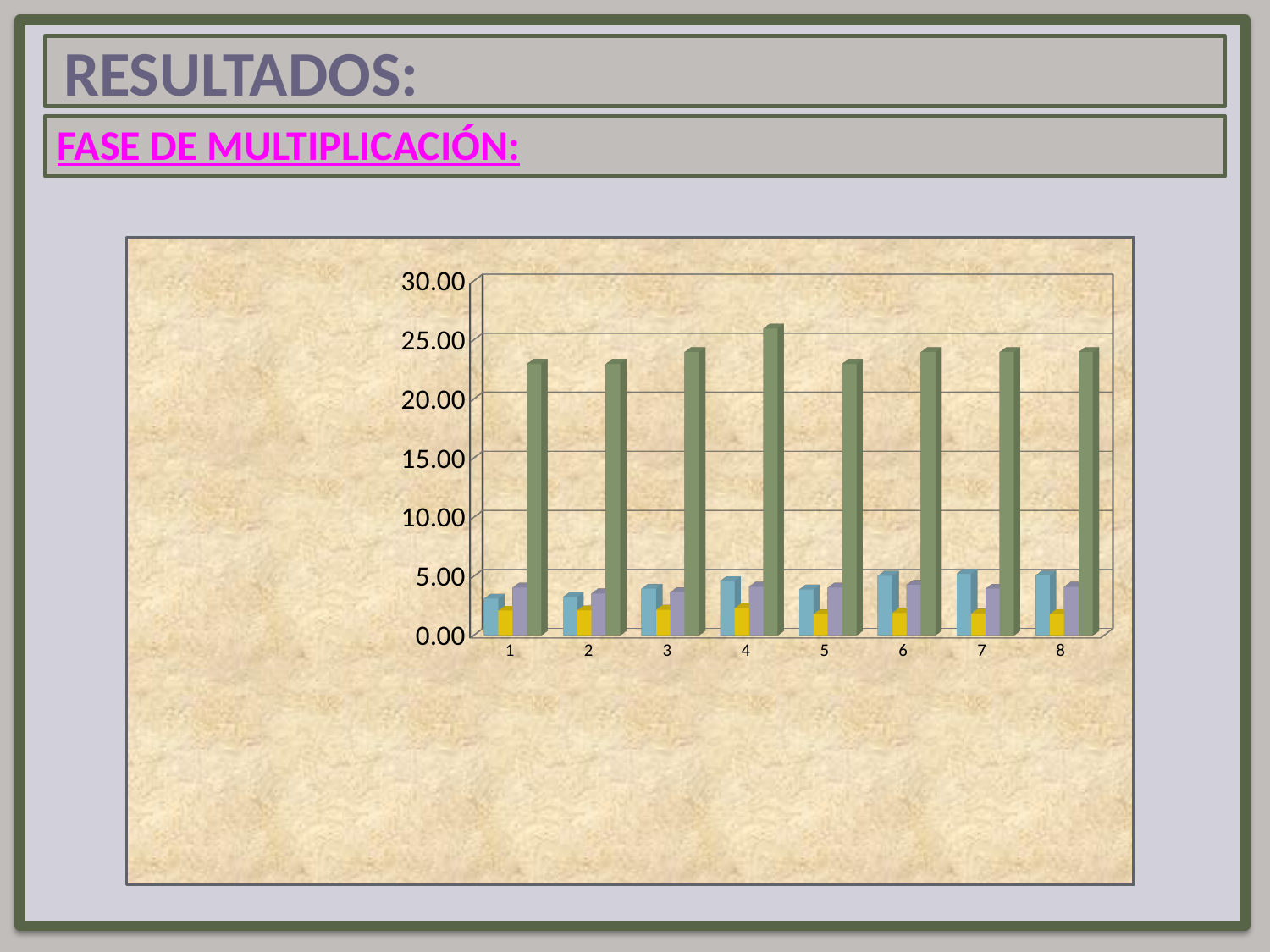
Among the tallest (green) bars, which category has the highest value? 4 Is the green bar for category 8 greater or less than 15.00? greater What is the highest value shown on the chart's vertical axis? 30.00 What kind of chart is shown on the slide? bar chart How many categories are shown along the x axis of the chart? 8 Is the blue bar for category 1 greater or less than 5.00? less Is the green bar for category 4 larger or smaller than the green bar for category 1? larger Is the yellow bar for category 3 greater or less than 5.00? less How many bars are plotted for each category in the chart? 4 What colour are the tallest bars in each category of the chart? green